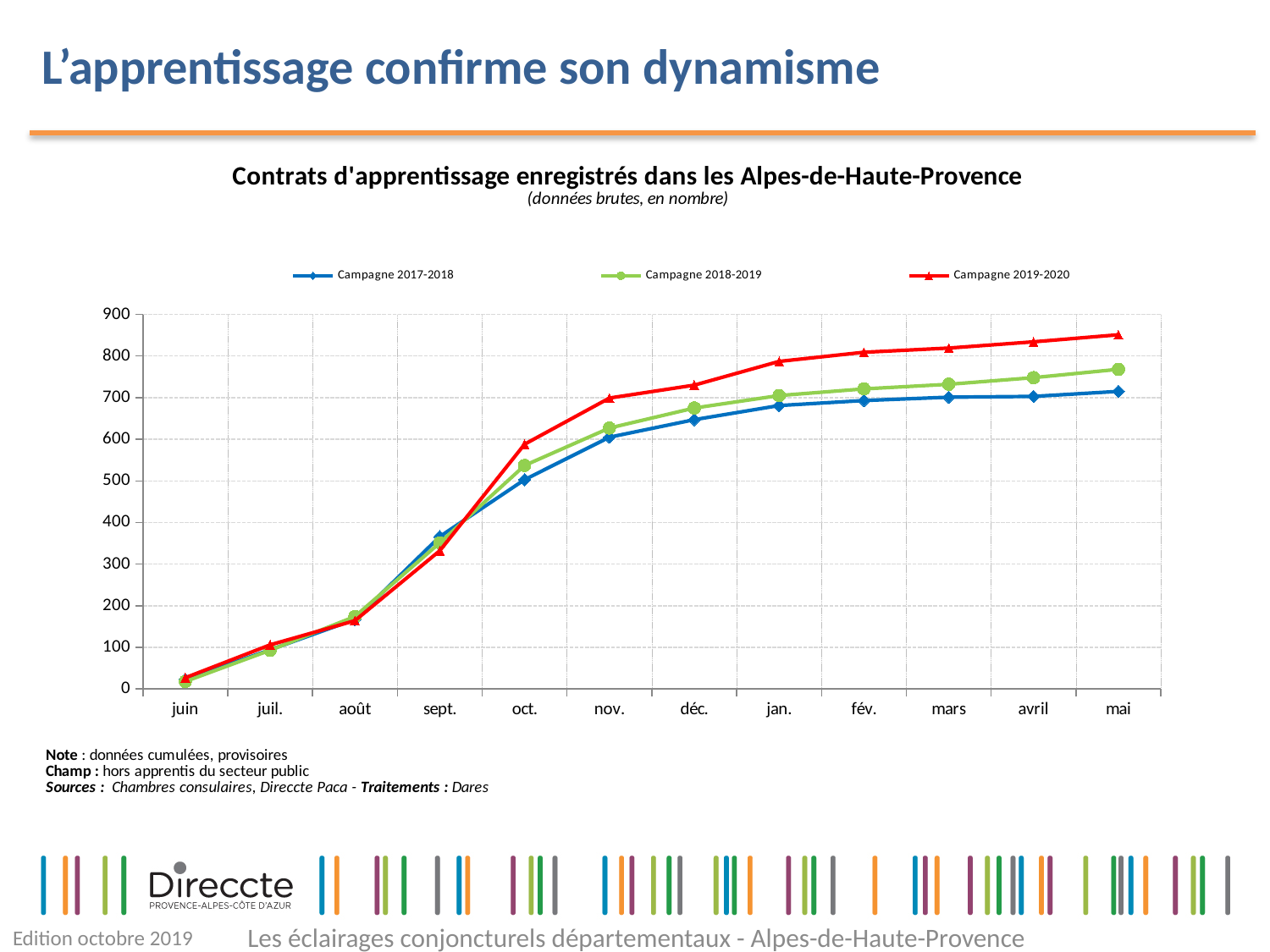
What colour is the line for Campagne 2019-2020? red Which series has the lowest value in mai? Campagne 2017-2018 How many series does the legend list? 3 How many months are shown along the x axis? 12 In mai, which series has the higher value, Campagne 2019-2020 or Campagne 2018-2019? Campagne 2019-2020 Do the values for Campagne 2019-2020 rise or fall from juin to mai? rise Is the value for Campagne 2018-2019 in nov. greater or less than 600? greater Is the value for Campagne 2019-2020 in mai greater or less than 800? greater Is the value for Campagne 2019-2020 in jan. greater or less than 700? greater Which series has the highest value in mai? Campagne 2019-2020 What kind of chart is shown on the slide? line chart